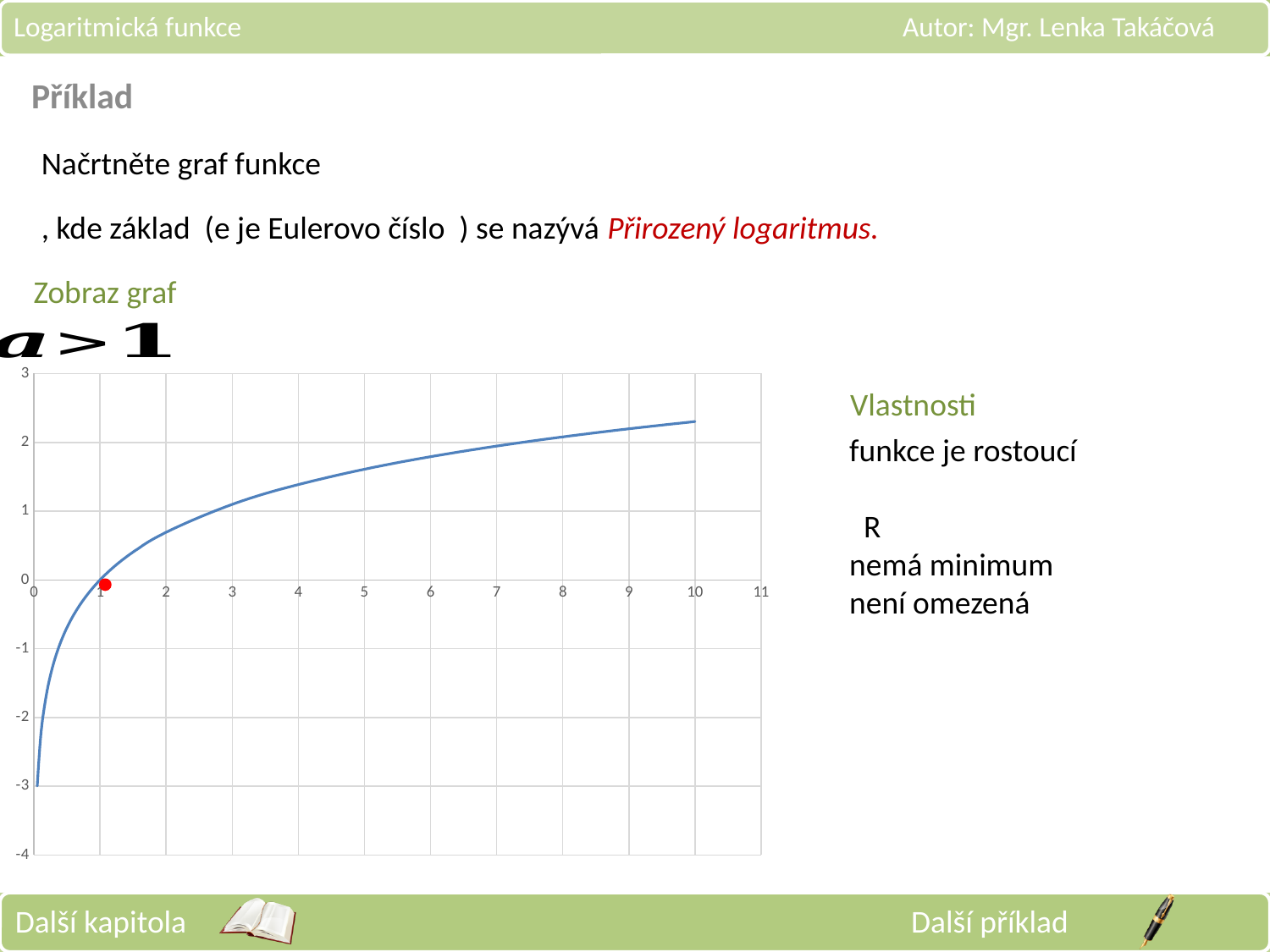
Is the value of the curve at x = 5 greater or less than 1? greater What kind of chart is shown on the slide? line chart Is the value of the curve at x = 2 greater or less than 1? less How many tick labels are shown on the x axis? 12 Is the value of the curve at x = 0.5 greater or less than 0? less What is the y value of the red marked point on the curve at x = 1? 0 Do the values of the plotted curve rise or fall as x increases? rise What is the lowest tick label shown on the y axis? -4 What is the highest tick label shown on the y axis? 3 Which is larger, the value of the curve at x = 10 or at x = 2? x = 10